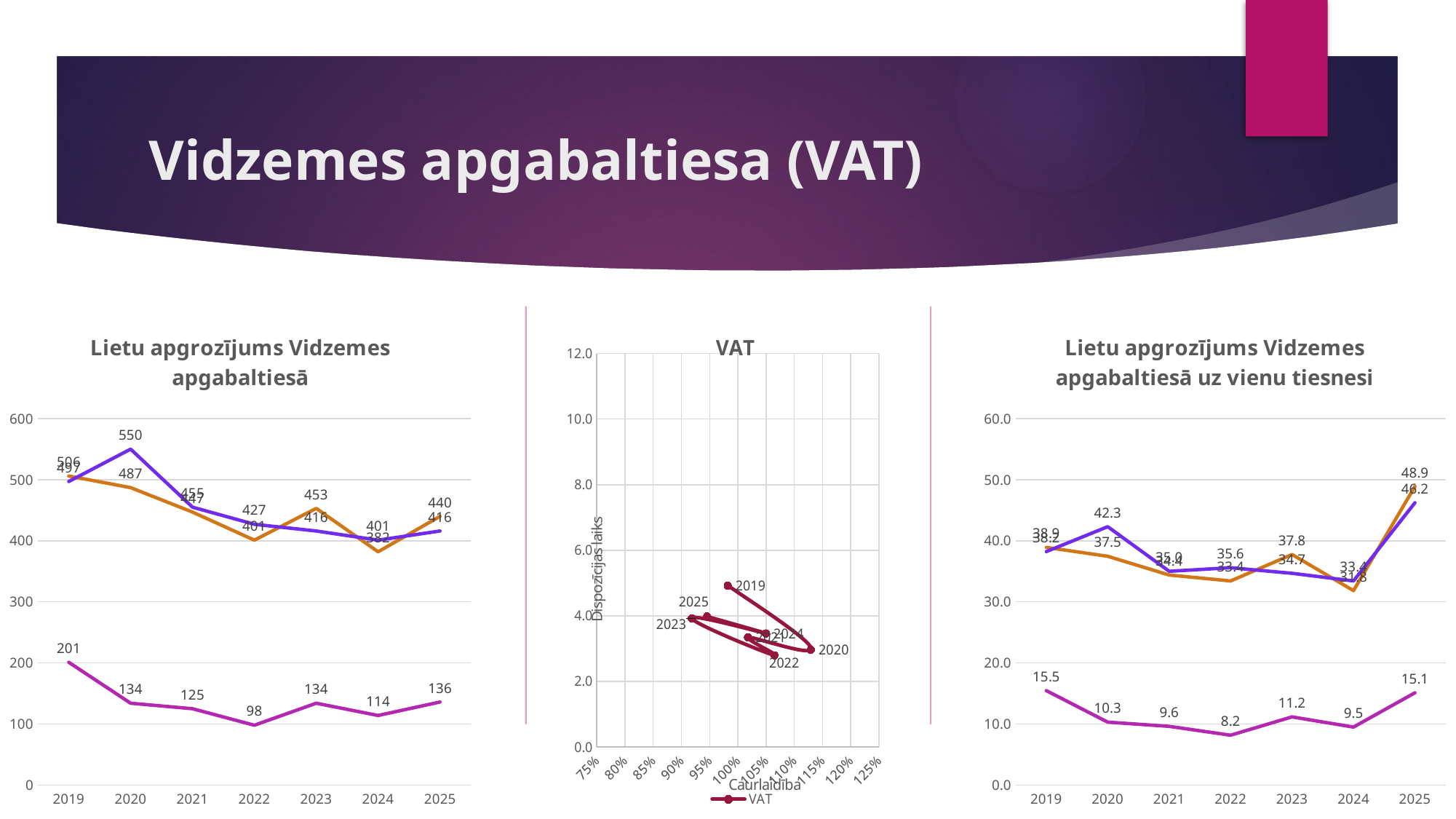
In the chart 'Lietu apgrozījums Vidzemes apgabaltiesā' on the left, in which year does the bottom (magenta) line reach its highest value? 2019 In the middle chart 'VAT', what is the title of the x axis? Caurlaidība In the chart 'Lietu apgrozījums Vidzemes apgabaltiesā' on the left, what is the value of the bottom (magenta) line in 2022? 98 In the chart 'Lietu apgrozījums Vidzemes apgabaltiesā' on the left, what is the highest value shown on any line, and in which year? 550 in 2020 In the chart 'Lietu apgrozījums Vidzemes apgabaltiesā' on the left, in which year does the bottom (magenta) line reach its lowest value? 2022 In the right chart 'Lietu apgrozījums Vidzemes apgabaltiesā uz vienu tiesnesi', what is the difference between the bottom (magenta) line's values in 2025 and 2024? 5.6 In the chart 'Lietu apgrozījums Vidzemes apgabaltiesā' on the left, by how much does the bottom (magenta) line fall from 2019 to 2020? 67 In the right chart 'Lietu apgrozījums Vidzemes apgabaltiesā uz vienu tiesnesi', what is the value of the bottom (magenta) line in 2025? 15.1 How many series does the legend of the middle chart 'VAT' list? 1 What kind of chart is the middle chart titled 'VAT'? Scatter (line) chart In the right chart 'Lietu apgrozījums Vidzemes apgabaltiesā uz vienu tiesnesi', in which year does the bottom (magenta) line reach its lowest value? 2022 How many years are shown on the x axis of the left chart 'Lietu apgrozījums Vidzemes apgabaltiesā'? 7